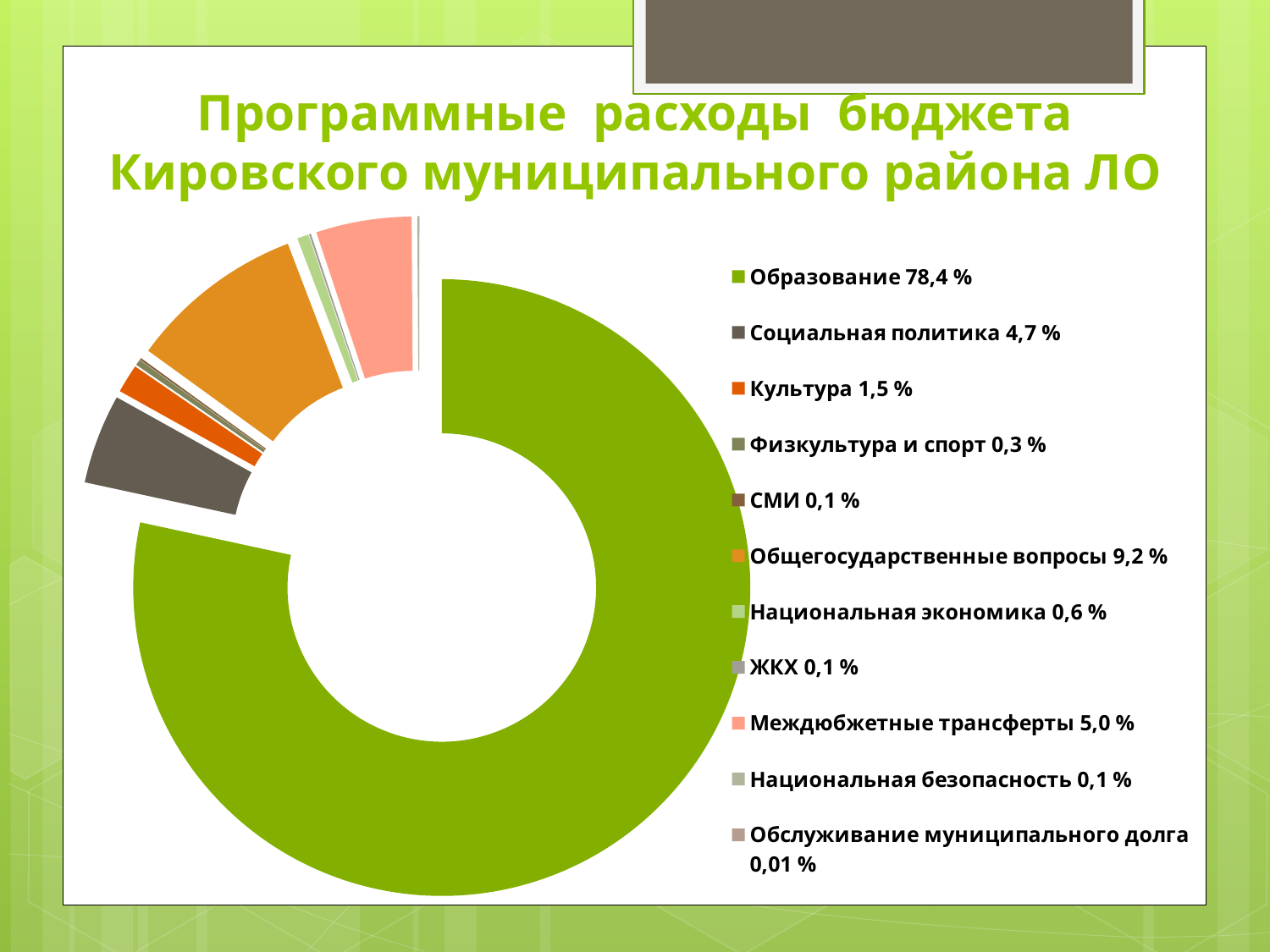
What kind of chart is shown on the slide? Doughnut (pie) chart What percentage is shown for Междюбжетные трансферты? 5,0 % What is the difference between the shares of Междюбжетные трансферты and Социальная политика? 0,3 % Which is larger: the share of Общегосударственные вопросы or Междюбжетные трансферты? Общегосударственные вопросы How many categories does the legend list? 11 What is the difference between the shares of Образование and Общегосударственные вопросы? 69,2 % What percentage is shown for Обслуживание муниципального долга? 0,01 % Which category has the largest share of the budget? Образование What share of the budget goes to Образование according to the legend? 78,4 % What percentage is shown for Общегосударственные вопросы? 9,2 % What percentage is shown for Социальная политика? 4,7 % Which category has the smallest share of the budget? Обслуживание муниципального долга